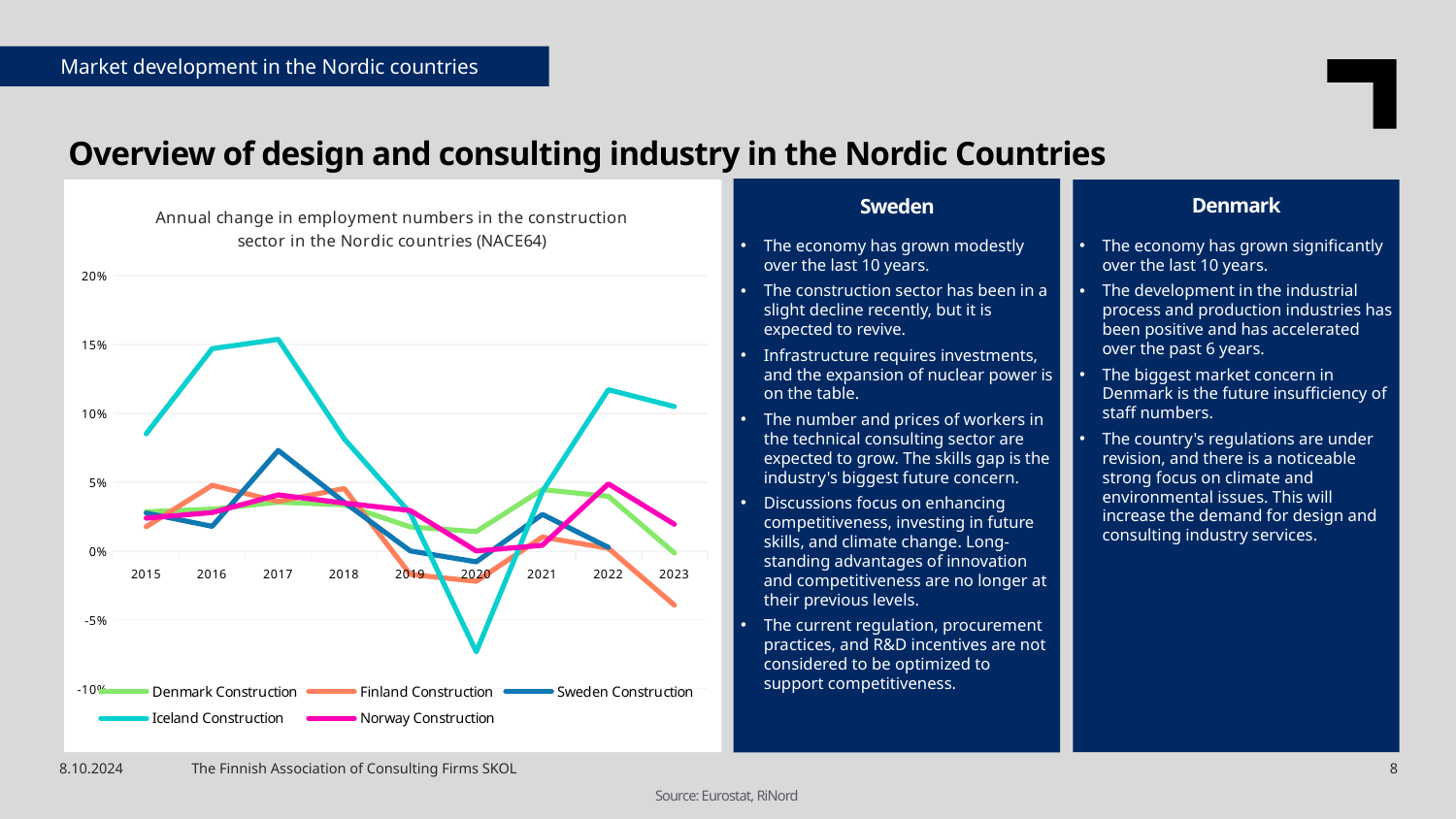
Is the value for Iceland Construction in 2017 greater or less than 10%? greater How many years are shown on the x axis of the chart? 9 In which year does Iceland Construction reach its lowest value? 2020 What is the title of the chart? Annual change in employment numbers in the construction sector in the Nordic countries (NACE64) Which series reaches the highest value on the chart? Iceland Construction How many series does the chart legend list? 5 Is the value for Finland Construction in 2023 greater or less than 0%? less What kind of chart is shown on the slide? Line chart Which is larger in 2017, Iceland Construction or Sweden Construction? Iceland Construction Is the value for Iceland Construction in 2020 greater or less than -5%? less Does the Iceland Construction line rise or fall from 2017 to 2020? Fall In which year does Iceland Construction reach its highest value? 2017